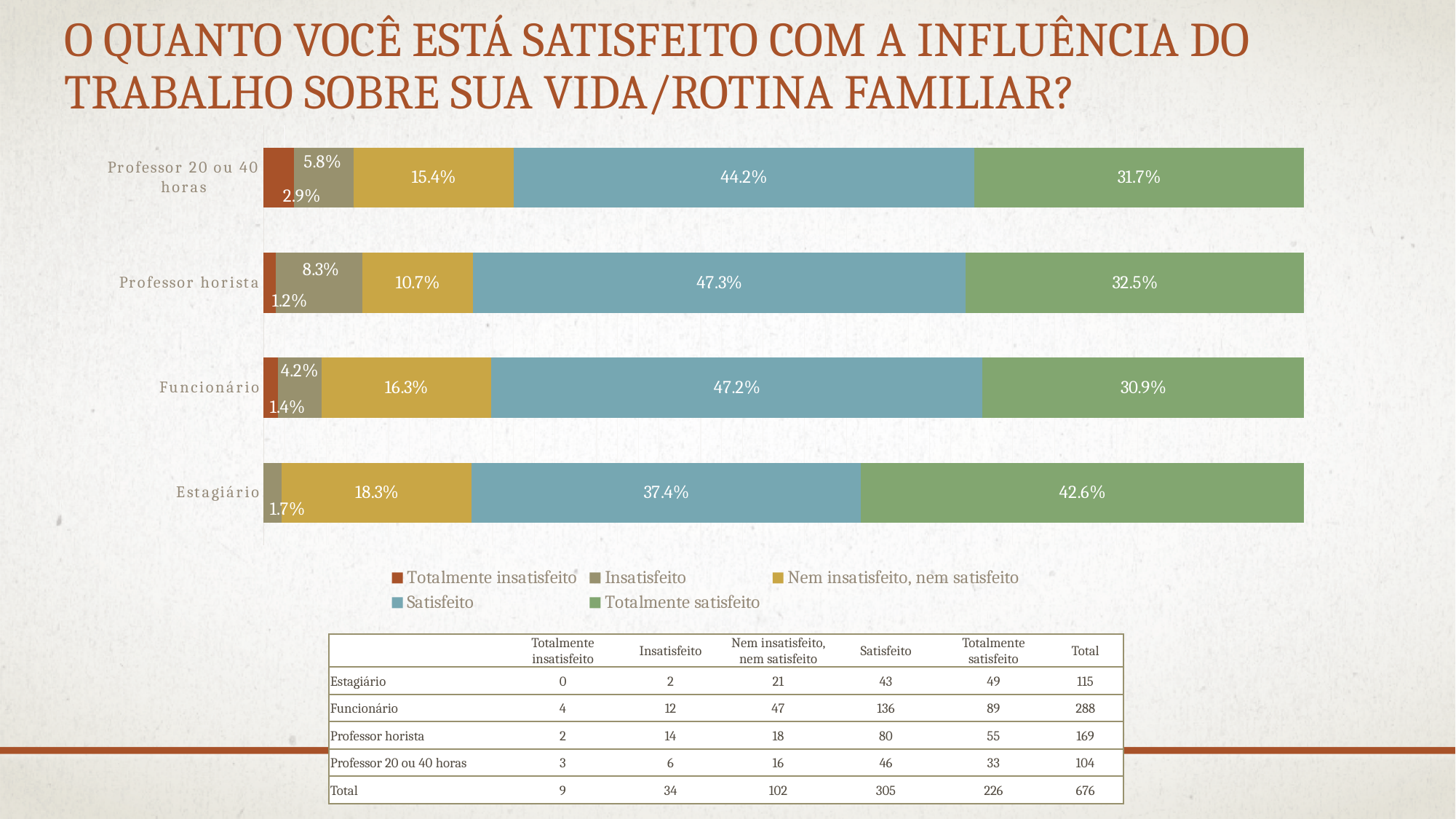
What kind of chart is shown on the slide? Stacked bar chart How many categories are shown on the chart? 4 What is the value of the Satisfeito segment for Professor horista? 47.3% Which colour represents the Satisfeito series in the chart? Blue Which has a larger Insatisfeito value: Professor horista or Professor 20 ou 40 horas? Professor horista What is the difference between the Nem insatisfeito, nem satisfeito values for Estagiário and Professor horista? 7.6 percentage points What is the value of the Totalmente satisfeito segment for Estagiário? 42.6% Which category has the highest Nem insatisfeito, nem satisfeito value? Estagiário How many series does the chart legend list? 5 Which category has the lowest Satisfeito value? Estagiário Which category has the highest Totalmente satisfeito value? Estagiário What is the value of the Totalmente insatisfeito segment for Funcionário? 1.4%